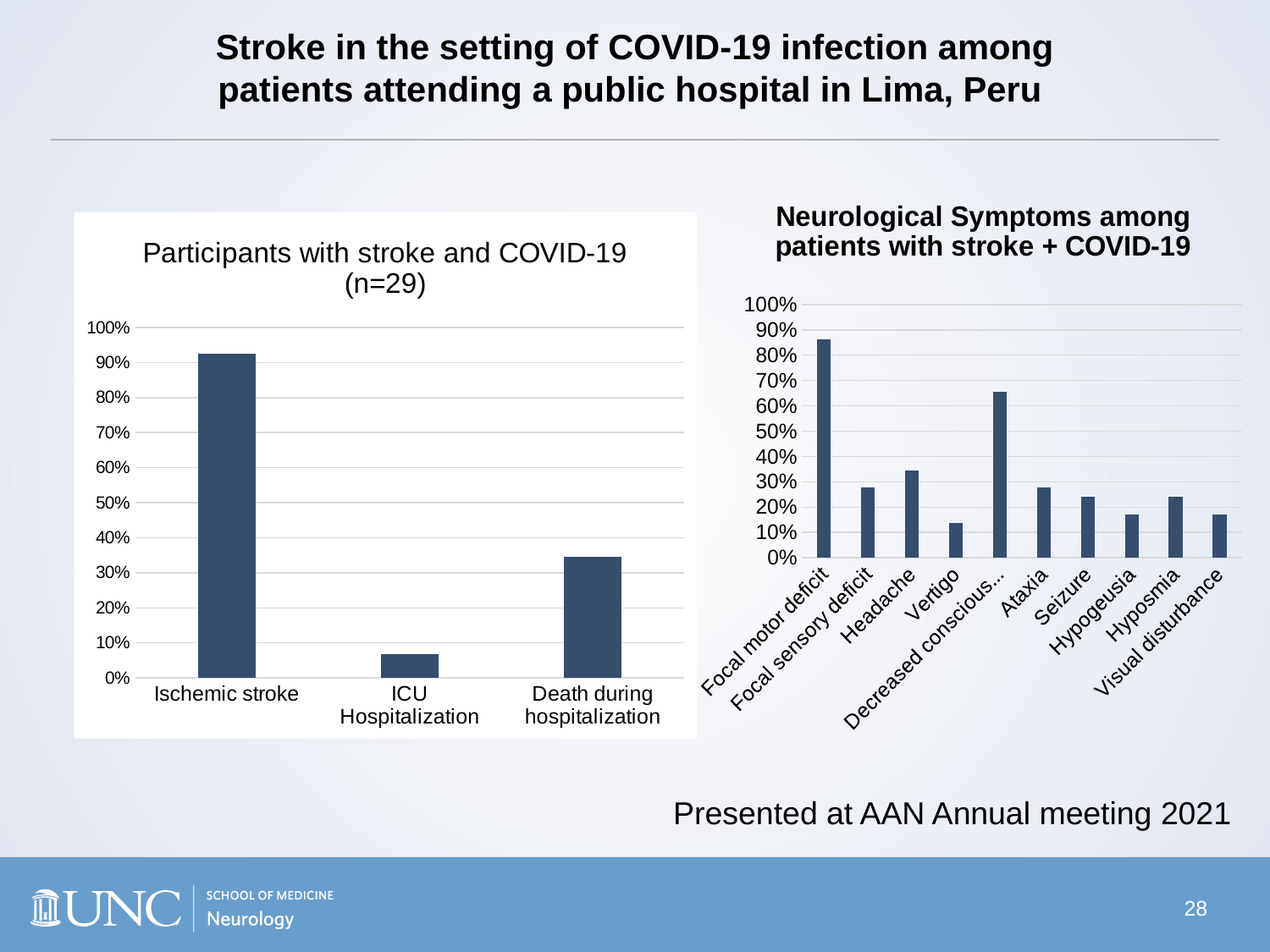
In the 'Participants with stroke and COVID-19 (n=29)' chart, is the value for Death during hospitalization greater or less than 30%? greater In the 'Neurological Symptoms among patients with stroke + COVID-19' chart, which symptom has the highest value? Focal motor deficit In the 'Participants with stroke and COVID-19 (n=29)' chart, is the value for Ischemic stroke greater or less than 90%? greater In the 'Participants with stroke and COVID-19 (n=29)' chart, which category has the highest value? Ischemic stroke What type of chart is the 'Neurological Symptoms among patients with stroke + COVID-19' chart? Bar chart In the 'Participants with stroke and COVID-19 (n=29)' chart, is the value for ICU Hospitalization greater or less than 10%? less In the 'Neurological Symptoms among patients with stroke + COVID-19' chart, which is larger, the value for Headache or the value for Seizure? Headache How many categories are shown in the 'Participants with stroke and COVID-19 (n=29)' chart? 3 How many symptom categories are shown in the 'Neurological Symptoms among patients with stroke + COVID-19' chart? 10 In the 'Participants with stroke and COVID-19 (n=29)' chart, which category has the lowest value? ICU Hospitalization